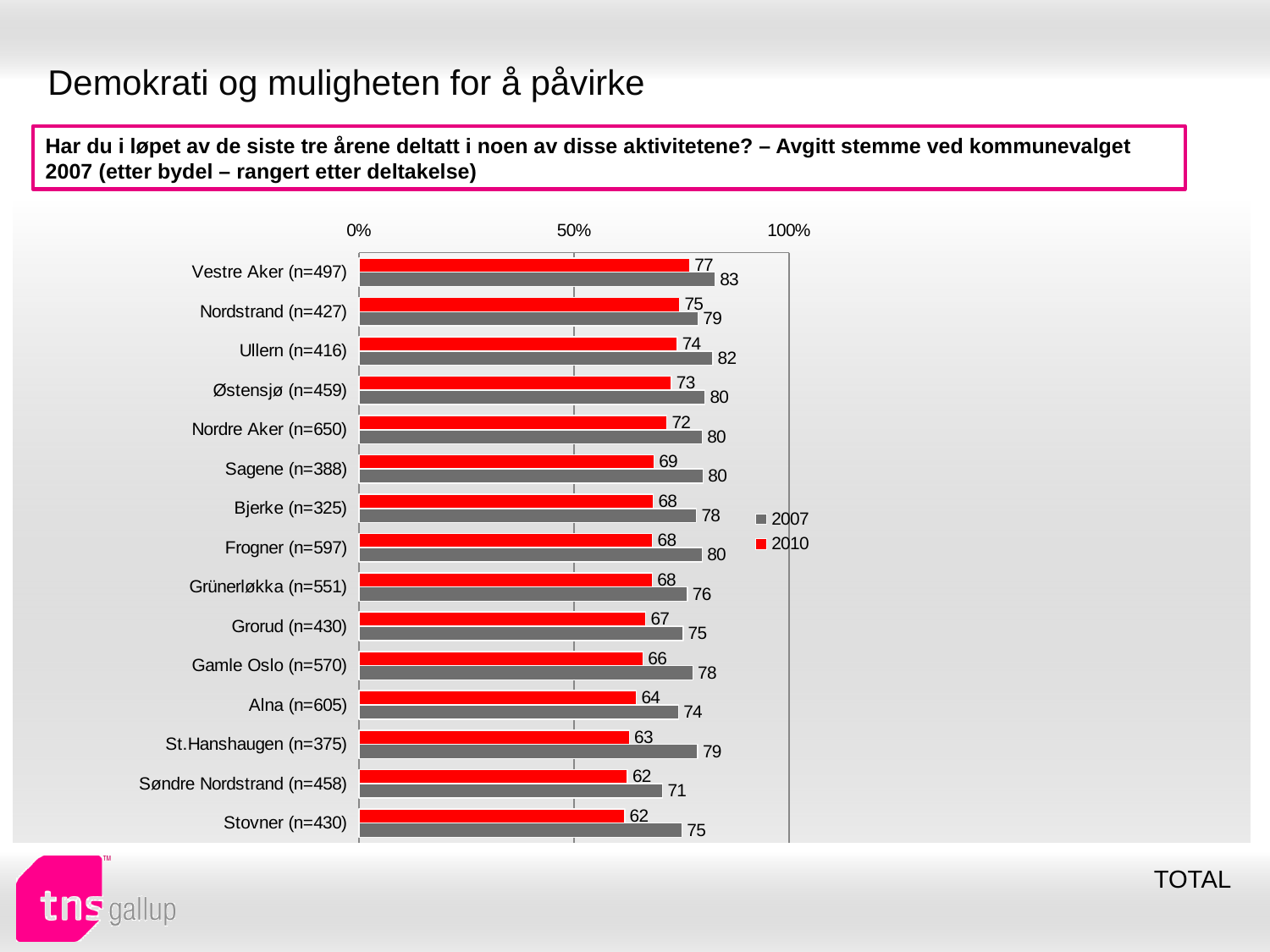
What kind of chart is shown on the slide? Bar chart Which district has the highest 2010 value? Vestre Aker (n=497) What is the 2007 value for Søndre Nordstrand (n=458)? 71 How many series does the legend list? 2 Which colour represents the 2010 series in the chart? Red What is the 2010 value for Vestre Aker (n=497)? 77 What is the 2007 value for St.Hanshaugen (n=375)? 79 How many districts (categories) are shown in the chart? 15 What is the difference between the 2007 and 2010 values for St.Hanshaugen (n=375)? 16 Which district has the lowest 2007 value? Søndre Nordstrand (n=458) Which district has the highest 2007 value? Vestre Aker (n=497) Which is larger for Ullern (n=416): the 2007 value or the 2010 value? 2007